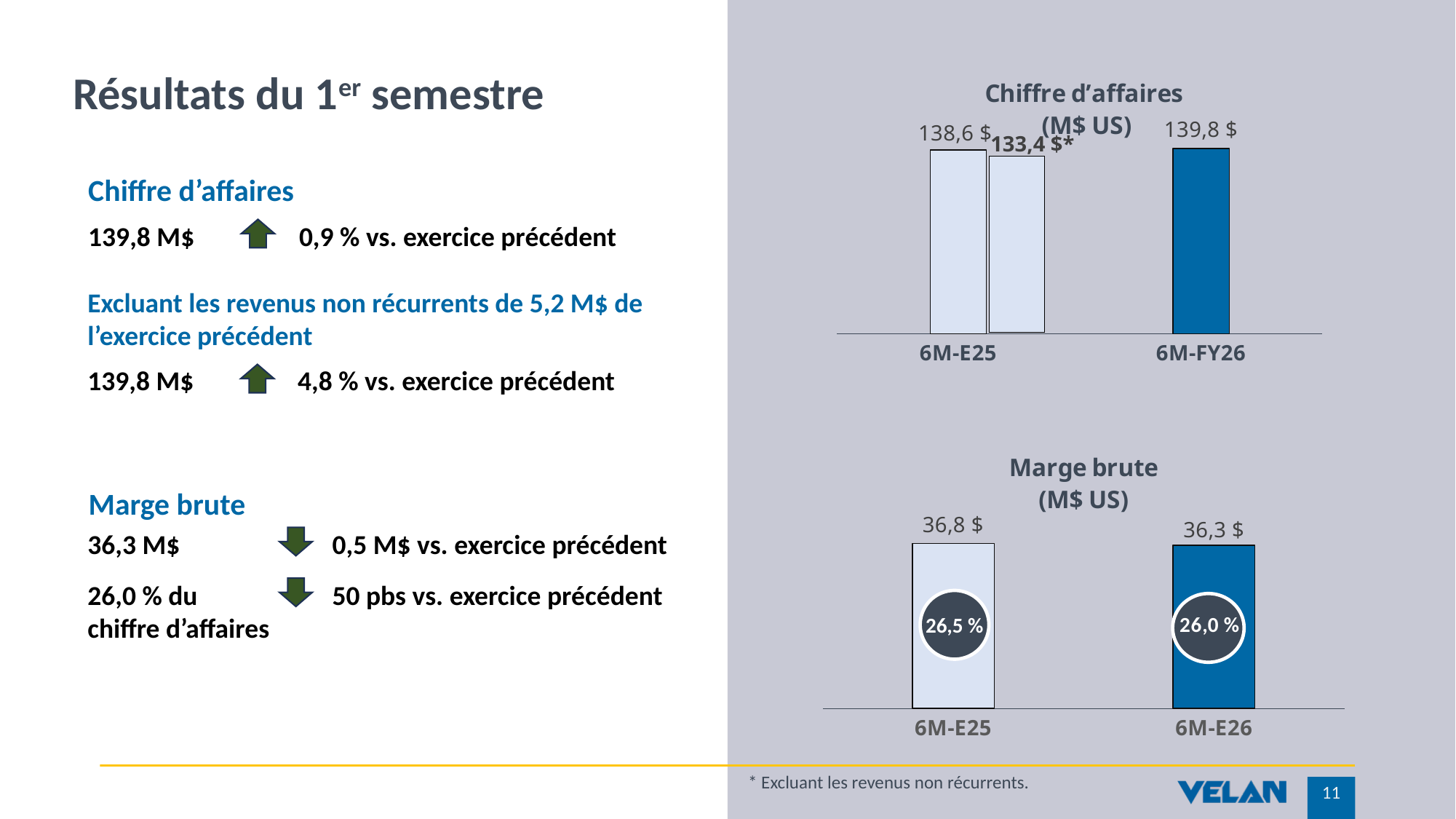
In the 'Chiffre d'affaires (M$ US)' chart, which is larger: the 6M-FY26 bar or the 133,4 $* bar for 6M-E25? 6M-FY26 In the 'Marge brute (M$ US)' chart, what percentage is shown in the circle on the 6M-E26 bar? 26,0 % In the 'Marge brute (M$ US)' chart, what is the value for 6M-E25? 36,8 $ In the 'Chiffre d'affaires (M$ US)' chart, what is the value for 6M-FY26? 139,8 $ In the 'Marge brute (M$ US)' chart, what percentage is shown in the circle on the 6M-E25 bar? 26,5 % In the 'Marge brute (M$ US)' chart, what is the value for 6M-E26? 36,3 $ In the 'Chiffre d'affaires (M$ US)' chart, what is the difference between the 6M-FY26 value and the reported 6M-E25 value of 138,6 $? 1,2 $ In the 'Marge brute (M$ US)' chart, what is the difference between the 6M-E25 and 6M-E26 values? 0,5 $ In the 'Chiffre d'affaires (M$ US)' chart, what is the value of the first (reported) bar for 6M-E25? 138,6 $ What type of chart is the 'Chiffre d'affaires (M$ US)' chart? Bar chart In the 'Chiffre d'affaires (M$ US)' chart, what is the value of the 6M-E25 bar marked with an asterisk (excluding non-recurring revenues)? 133,4 $* In the 'Marge brute (M$ US)' chart, how many categories are shown on the x axis? 2